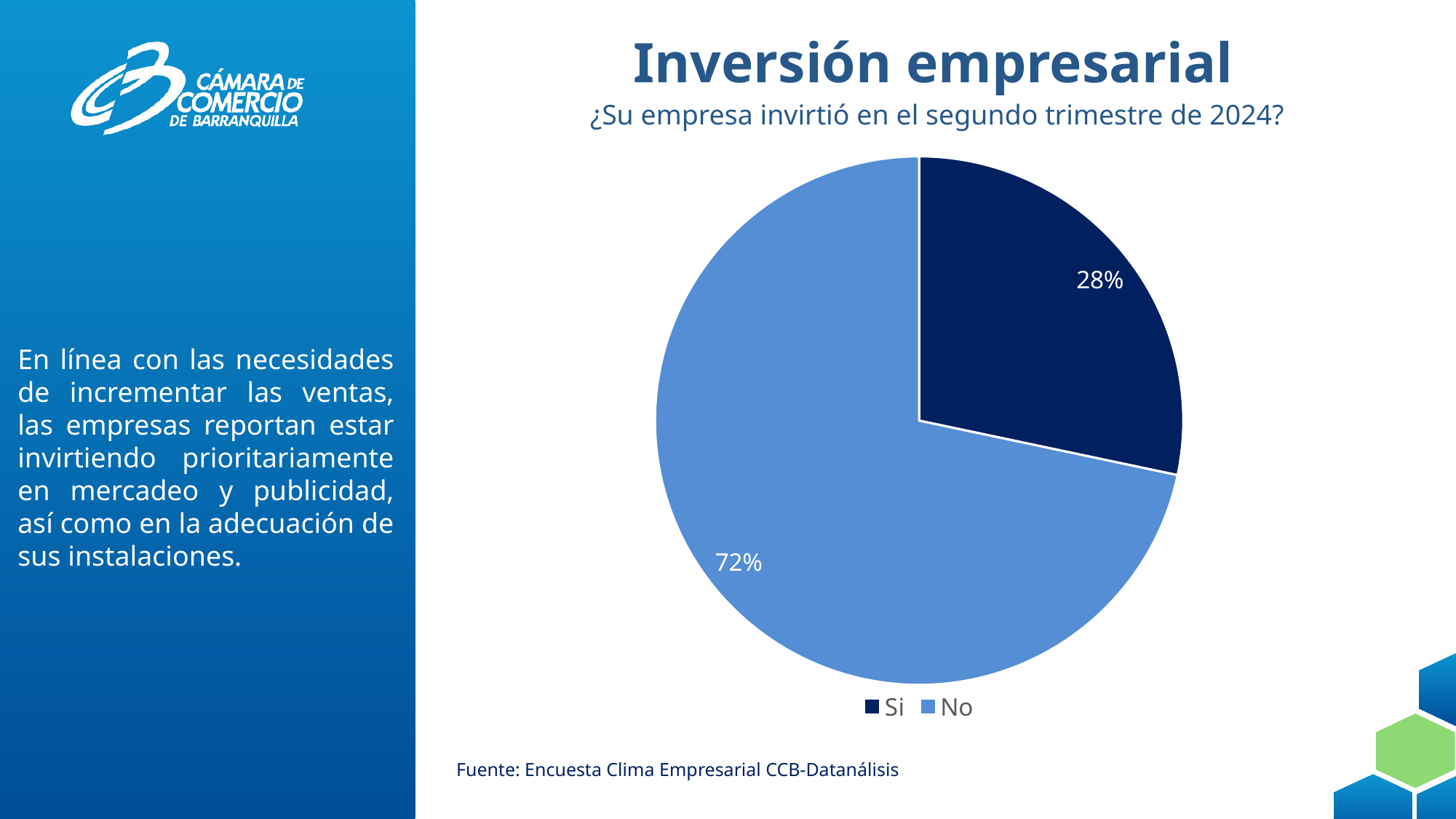
What colour is the "Si" slice in the pie chart? dark navy blue What type of chart is shown on the slide? pie chart What is the difference in percentage points between the "No" and "Si" slices? 44 What share of the pie does the "No" slice represent? 72% Which slice is the largest in the pie chart? No What is the title of the chart? Inversión empresarial What share of the pie does the "Si" slice represent? 28% What is the total of the two slices shown in the pie chart? 100% Which slice is the smallest in the pie chart? Si Which is larger, the "Si" slice or the "No" slice? No How many entries does the legend list? 2 How many slices does the pie chart have? 2